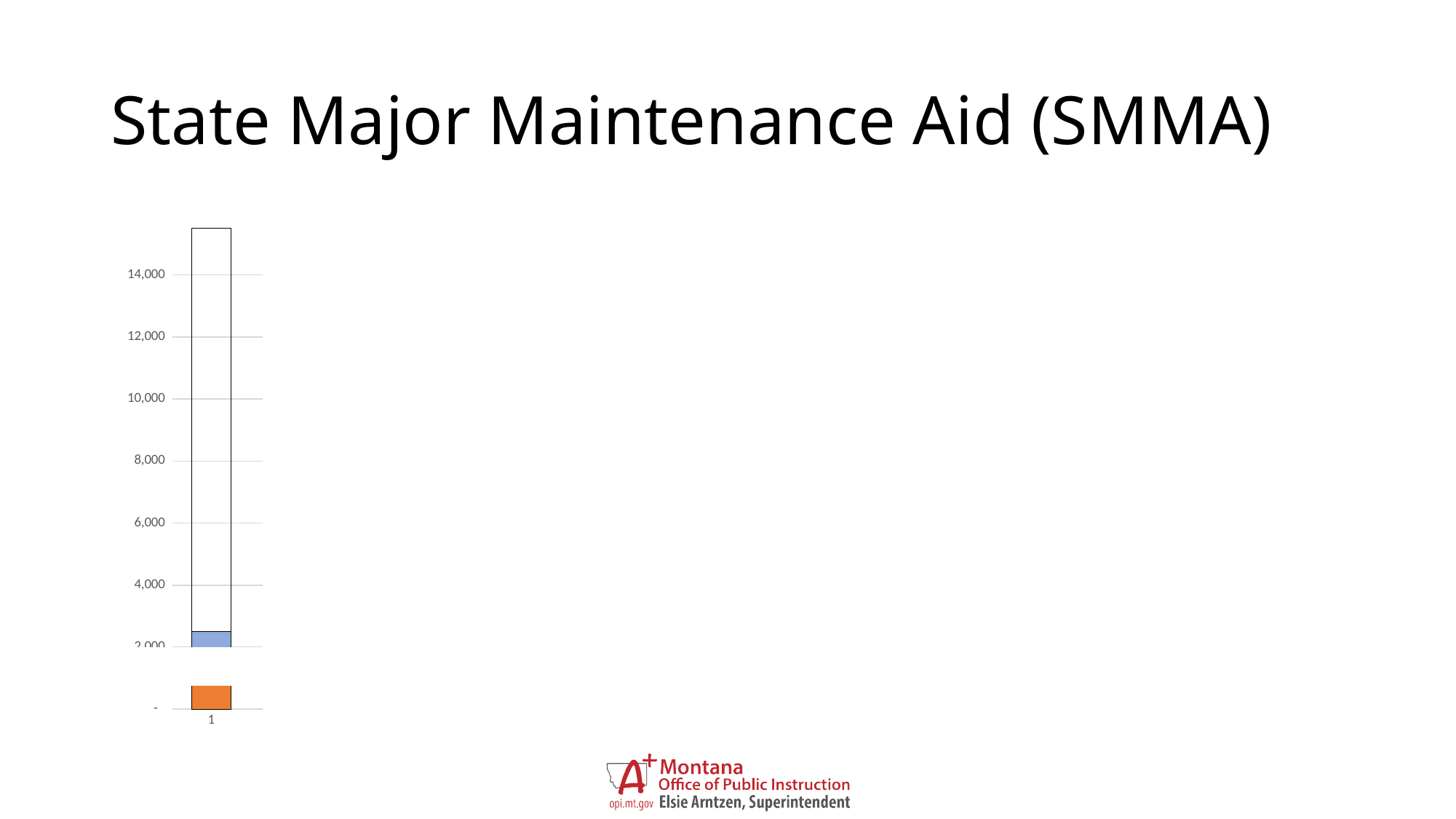
How many categories are shown on the x axis of the chart? 1 Is the top of the blue segment of the bar for category 1 greater or less than 4,000? less What is the label of the single category on the x axis? 1 Is the top of the orange segment of the bar for category 1 greater or less than 2,000? less What is the highest labelled tick on the vertical axis of the chart? 14,000 Is the top of the stacked bar for category 1 greater or less than 14,000? greater What kind of chart is shown on the slide? bar chart